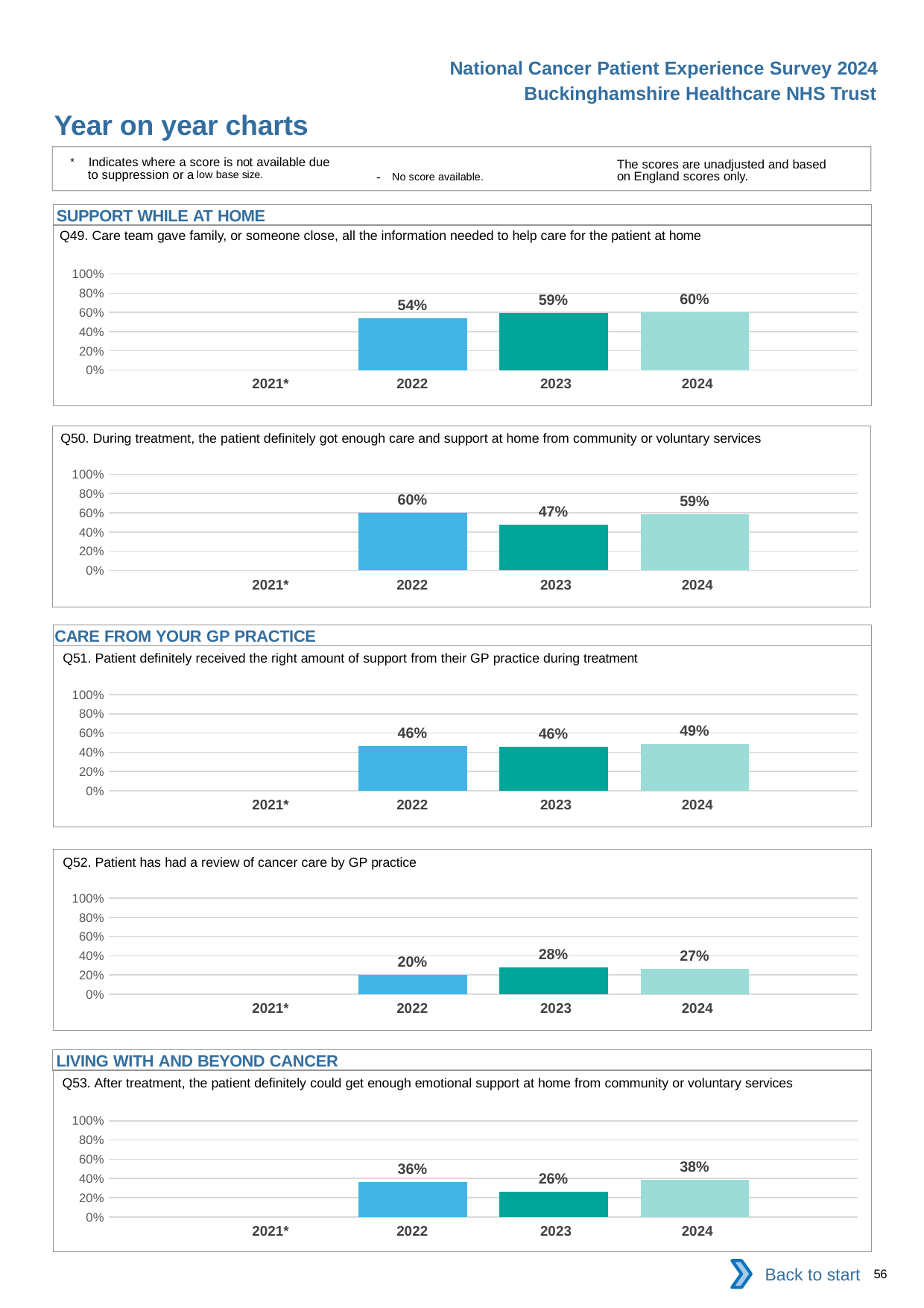
In the Q53 chart, is the value for 2022 greater or less than 40%? less What kind of chart is the Q52 chart? bar chart In the Q51 chart, what is the value for 2023? 46% In the Q49 chart, what is the value for 2024? 60% In the Q51 chart, which year has the highest value? 2024 How many year categories are shown on the x axis of the Q49 chart? 4 In the Q49 chart, do the values rise or fall from 2022 to 2024? rise In the Q52 chart, is the value for 2023 larger or smaller than the value for 2022? larger In the Q52 chart, what is the value for 2022? 20% In the Q50 chart, what is the difference between the 2022 and 2023 values? 13% In the Q50 chart, which year has the lowest value? 2023 In the Q53 chart, what is the difference between the 2024 and 2023 values? 12%